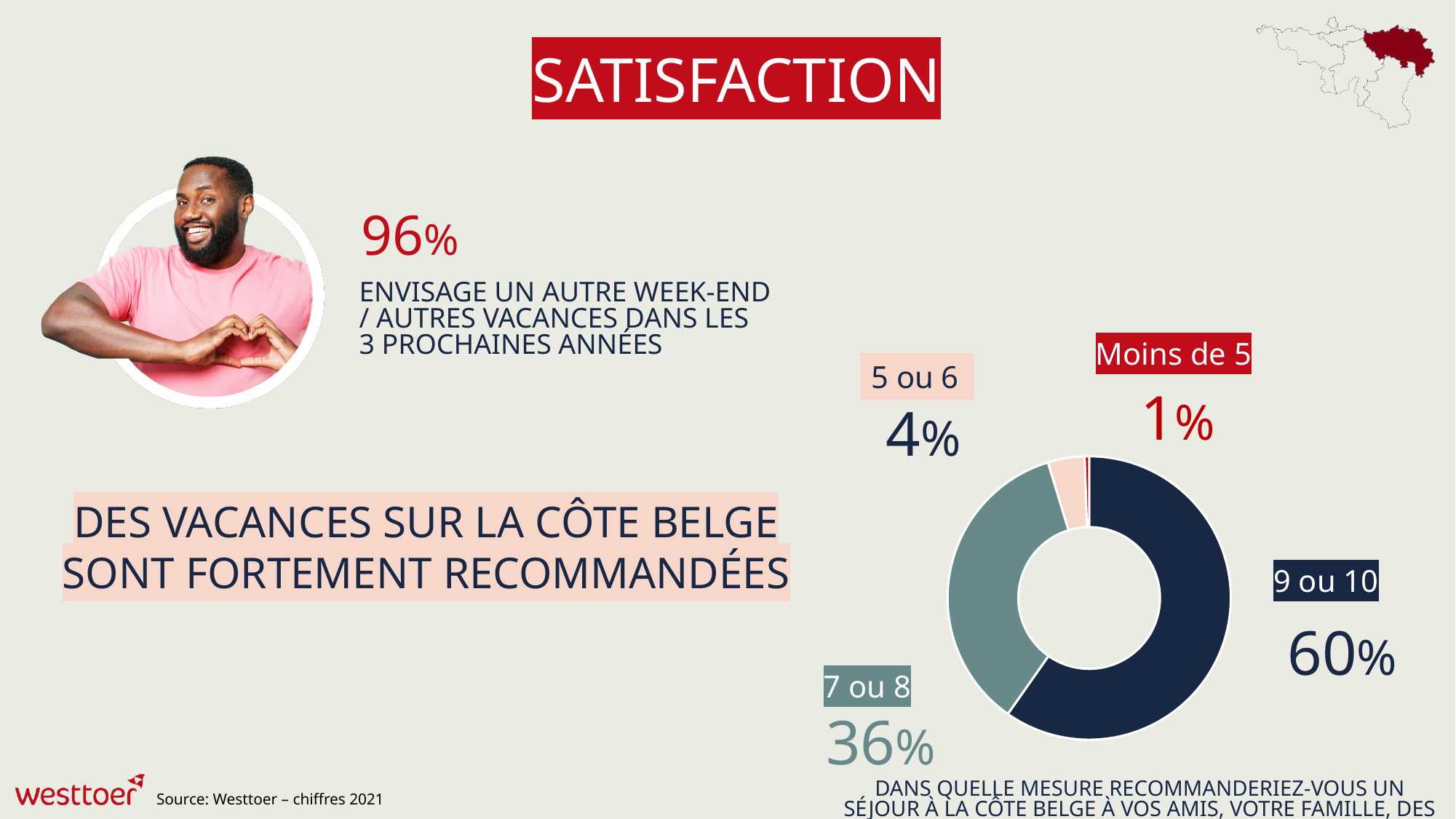
What kind of chart is shown on the slide? Doughnut (pie) chart Which is larger, the share for 7 ou 8 or the share for 5 ou 6? 7 ou 8 What is the combined share of 5 ou 6 and Moins de 5? 5% What share of respondents gave a score of Moins de 5? 1% What share of respondents gave a score of 7 ou 8? 36% What share of respondents gave a score of 5 ou 6? 4% Which category has the largest share in the chart? 9 ou 10 What is the difference between the shares for 9 ou 10 and 7 ou 8? 24% Which category has the smallest share in the chart? Moins de 5 How many categories does the chart show? 4 What share of respondents gave a score of 9 ou 10? 60% What colour is the 9 ou 10 segment of the chart? Dark navy blue